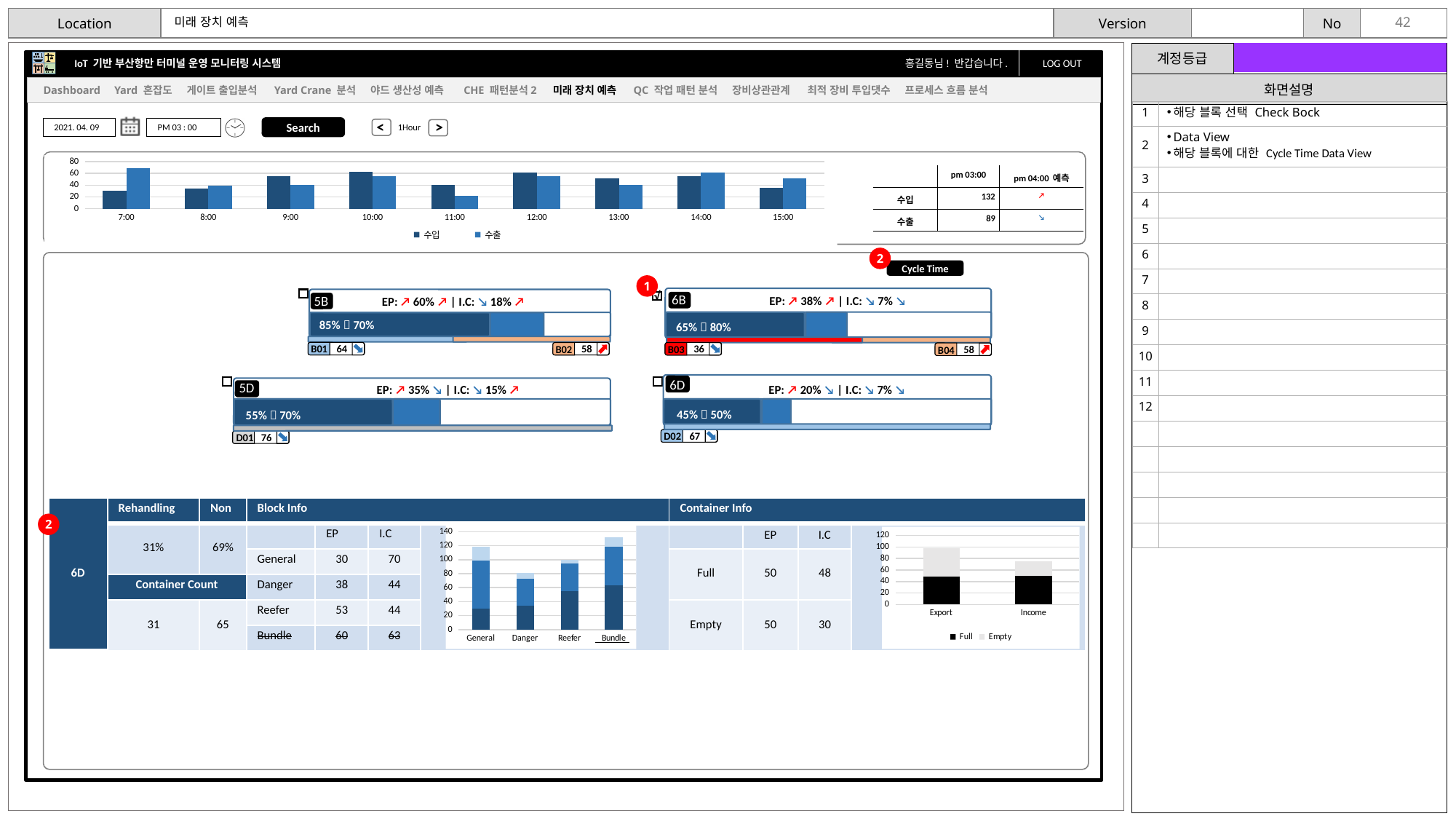
In the top hourly chart, how many series does the legend list? 2 In the Block Info stacked bar chart, which category has the shortest bar? Danger What type of chart is the chart at the top of the slide showing hourly values from 7:00 to 15:00? bar chart In the top hourly chart, is the 수출 value at 7:00 greater or less than 60? greater In the top hourly chart, how many time categories are shown on the x axis? 9 In the Block Info stacked bar chart, which category has the tallest bar? Bundle In the Container Info chart, how many series does the legend list? 2 In the Block Info stacked bar chart, how many categories are shown on the x axis? 4 In the Container Info chart, which bar is taller, Export or Income? Export In the top hourly chart, which series is larger at 11:00, 수입 or 수출? 수입 In the top hourly chart, which series is larger at 7:00, 수입 or 수출? 수출 In the top hourly chart, is the 수출 value at 11:00 greater or less than 40? less